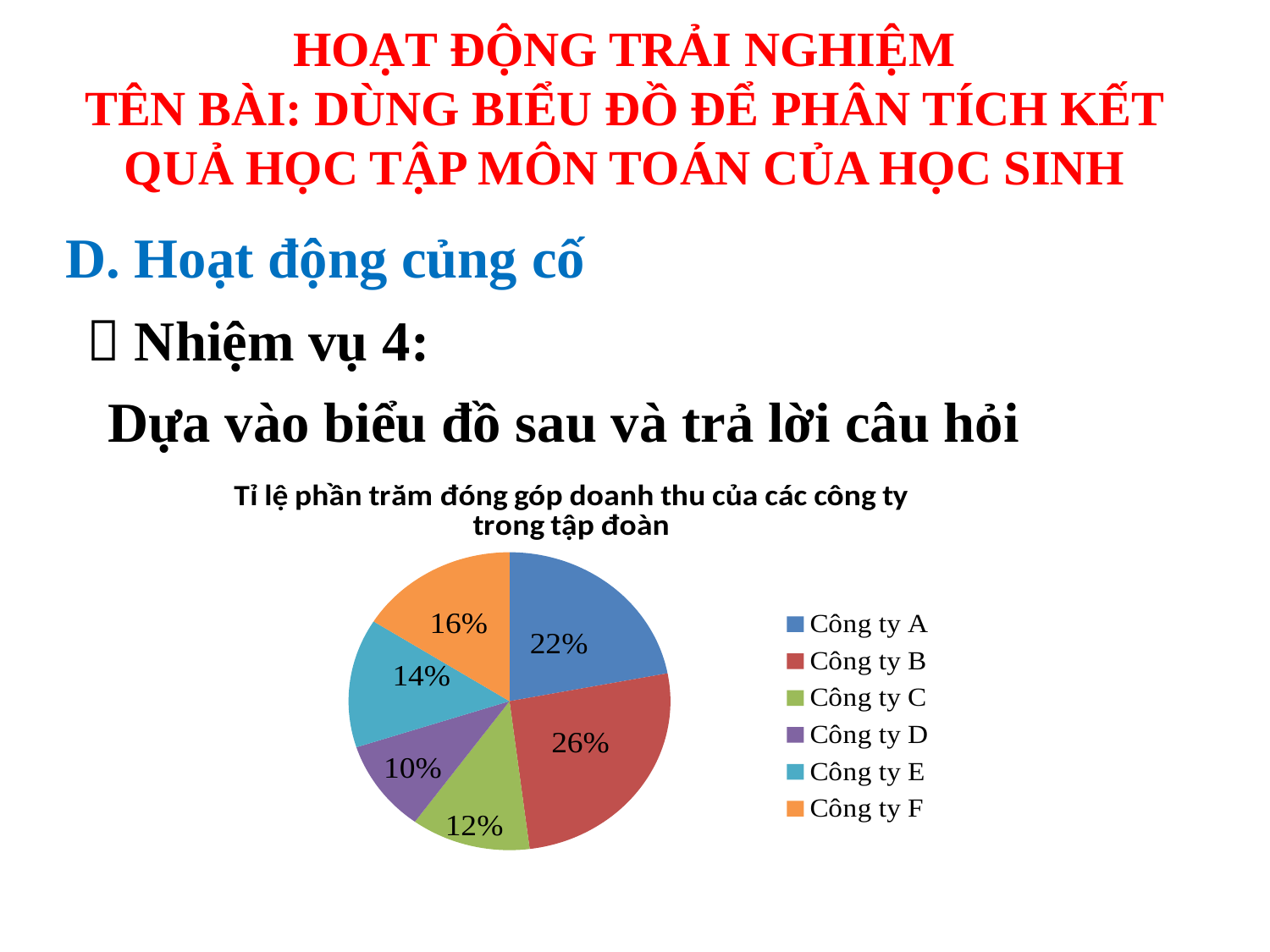
What is the title of the pie chart? Tỉ lệ phần trăm đóng góp doanh thu của các công ty trong tập đoàn What is the percentage share for Công ty B? 26% What colour is the slice for Công ty C? Green What kind of chart is shown on the slide? Pie chart What is the percentage share for Công ty F? 16% Which has a larger share, Công ty E or Công ty F? Công ty F How many companies are shown in the pie chart? 6 Which company has the smallest share of the pie? Công ty D What is the percentage share for Công ty D? 10% What is the percentage share for Công ty A? 22% Which company has the largest share of the pie? Công ty B What is the difference in percentage points between Công ty B and Công ty C? 14